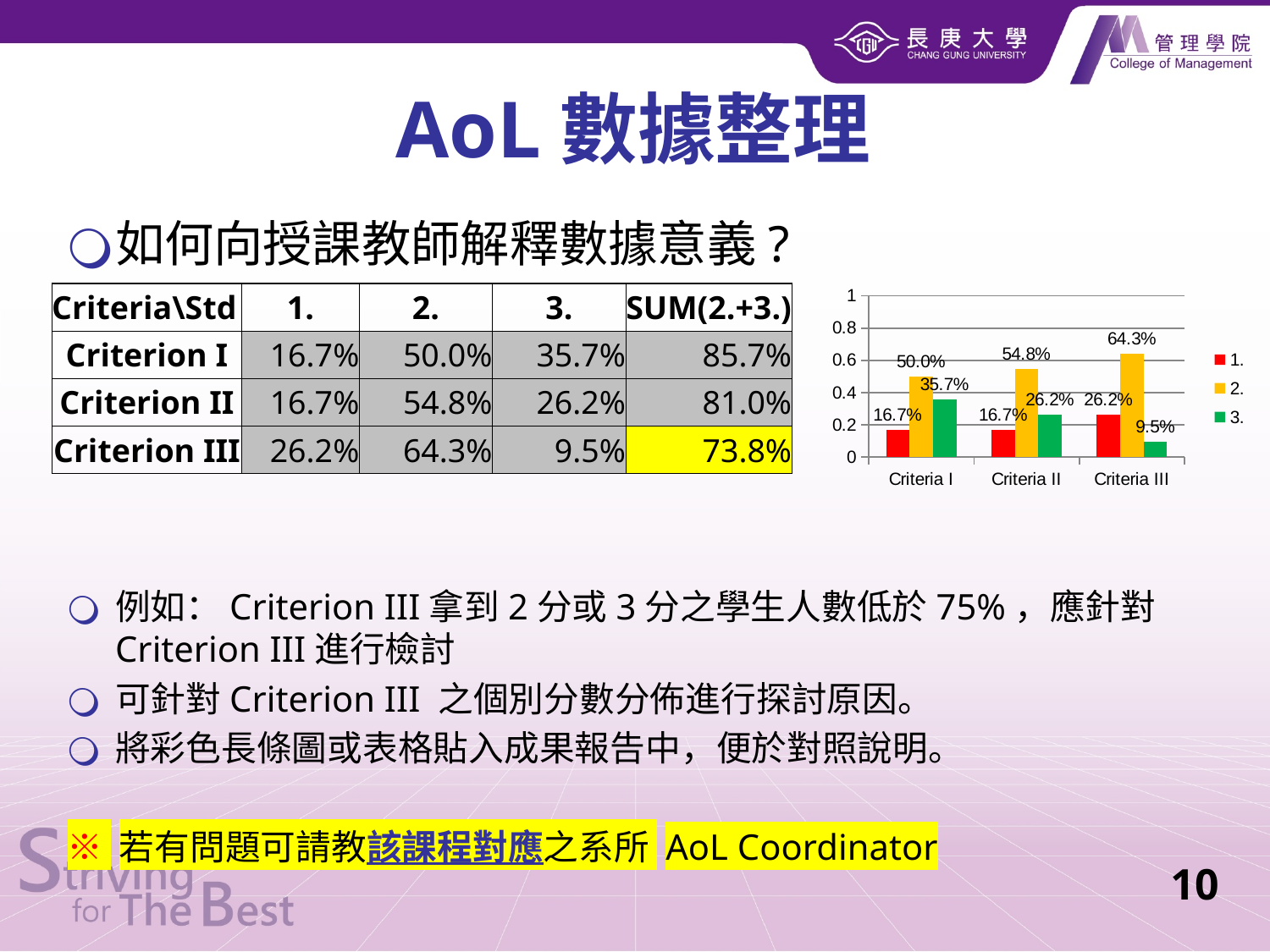
What is the difference between the series 2. values for Criteria III and Criteria I in the chart? 14.3% What is the value of series 3. for Criteria I in the chart? 35.7% Which is larger in the chart: series 3. for Criteria I or series 3. for Criteria II? Criteria I What colour are the bars for series 2. in the chart? yellow How many categories are shown on the x axis of the chart? 3 Which category has the highest value for series 2. in the chart? Criteria III Which category has the lowest value for series 3. in the chart? Criteria III Is the series 2. value for Criteria II greater or less than 0.4 on the chart's axis? greater What is the value of series 1. for Criteria II in the chart? 16.7% What is the value of series 2. for Criteria III in the chart? 64.3% What type of chart is shown on the slide? bar chart How many series does the chart legend list? 3